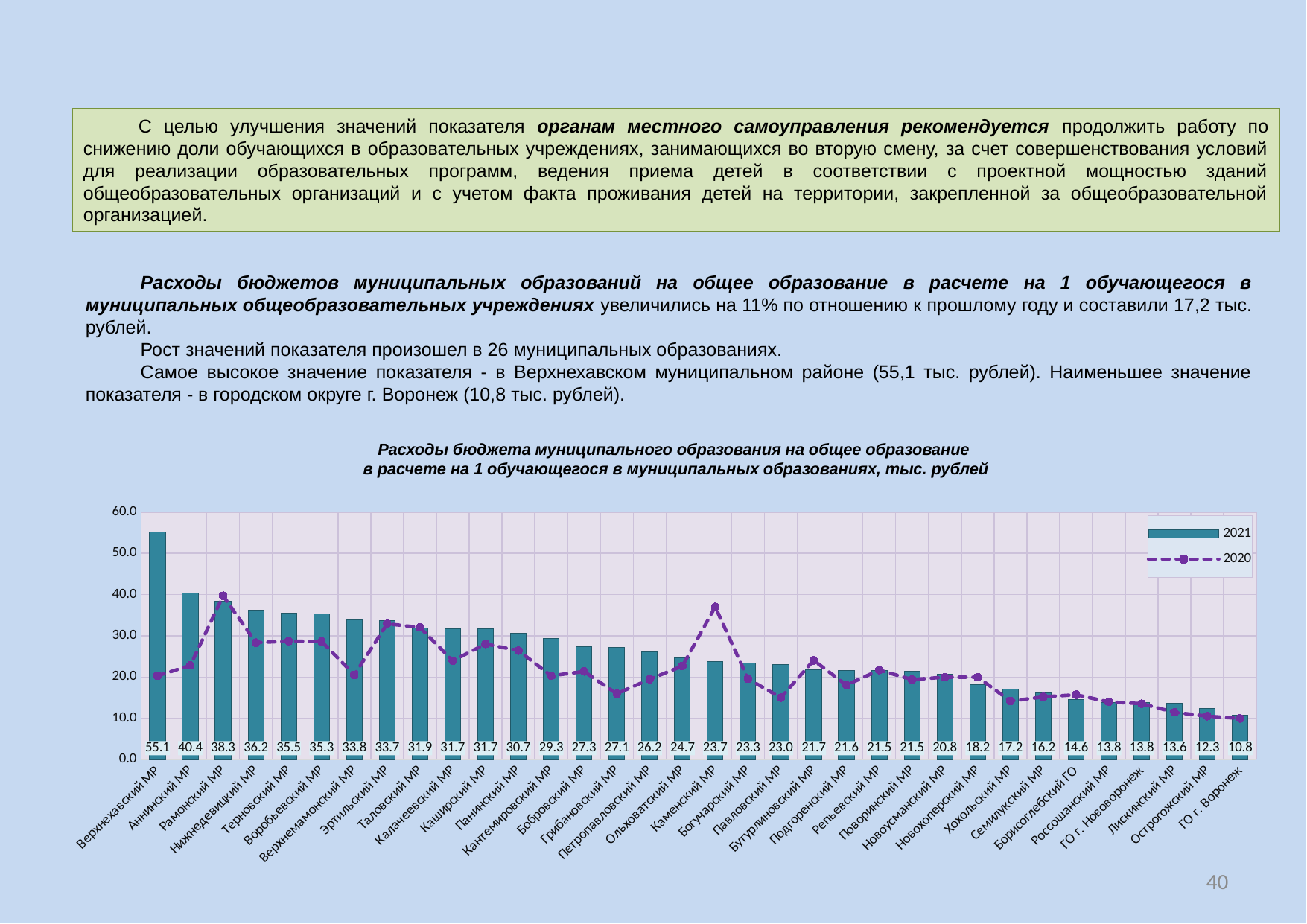
How many series does the legend list? 2 Is the 2020 value for Каменский МР greater or less than 30.0? greater What kind of chart is used for the 2021 series? bar chart What is the difference between the 2021 values for Аннинский МР and Рамонский МР? 2.1 What is the 2021 value for Верхнехавский МР? 55.1 What is the 2021 value for Каменский МР? 23.7 Which municipality has the highest 2021 value? Верхнехавский МР Which has a larger 2021 value, Панинский МР or Бобровский МР? Панинский МР What is the 2021 value for ГО г. Воронеж? 10.8 Which municipality has the lowest 2021 value? ГО г. Воронеж How many municipalities are shown on the x axis? 34 Do the 2021 values rise or fall from left to right along the x axis? fall